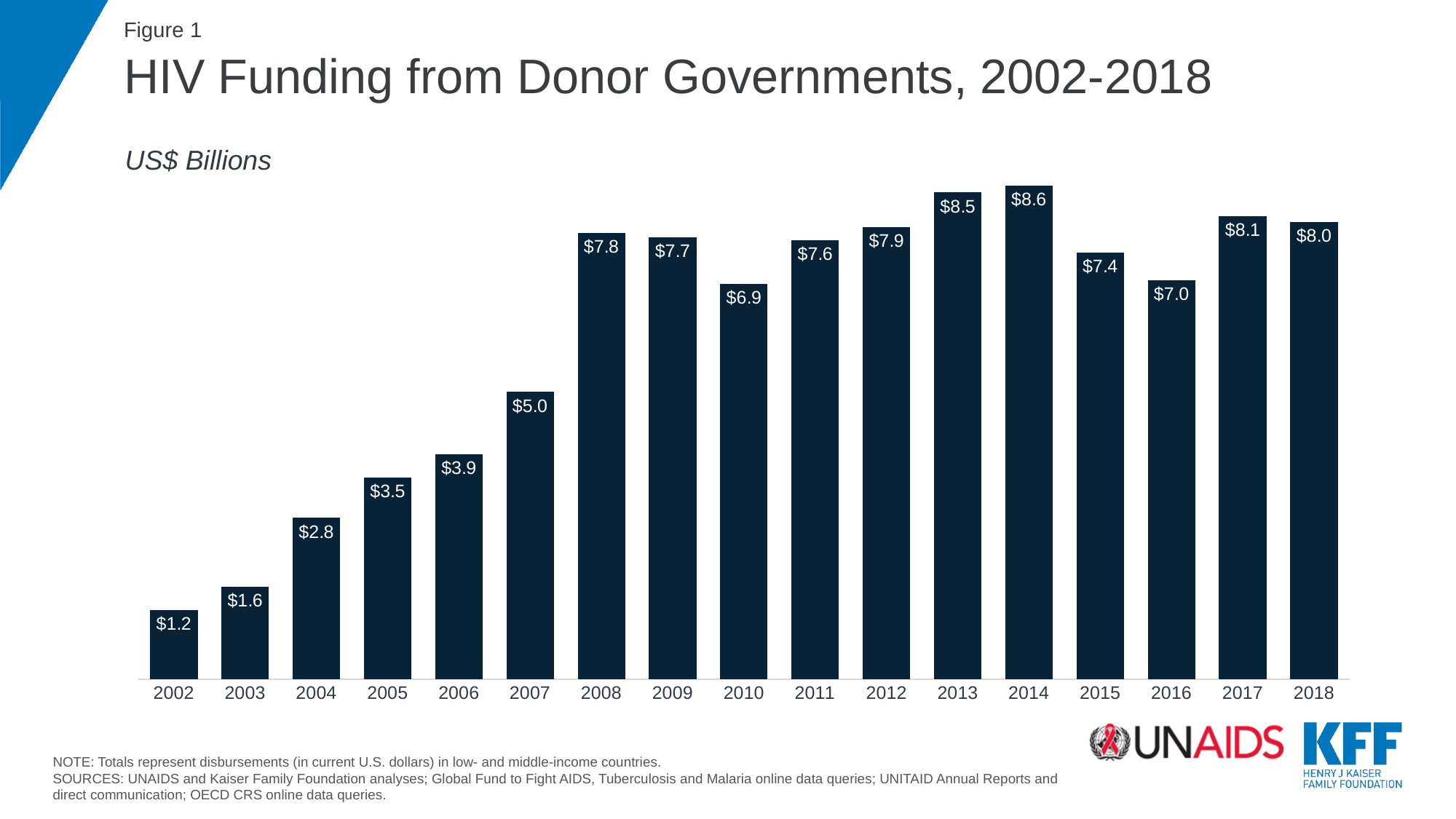
What was HIV funding from donor governments in 2008? $7.8 What was HIV funding from donor governments in 2002? $1.2 What was HIV funding from donor governments in 2016? $7.0 Which year had higher HIV funding, 2010 or 2015? 2015 Which year had the lowest HIV funding from donor governments? 2002 What is the difference in HIV funding between 2007 and 2008? $2.8 What kind of chart is shown on the slide? Bar chart Did HIV funding from donor governments rise or fall between 2002 and 2008? Rise In what units are the values on the chart expressed? US$ Billions What is the difference in HIV funding between 2014 and 2018? $0.6 Which year had the highest HIV funding from donor governments? 2014 How many years are shown on the chart? 17